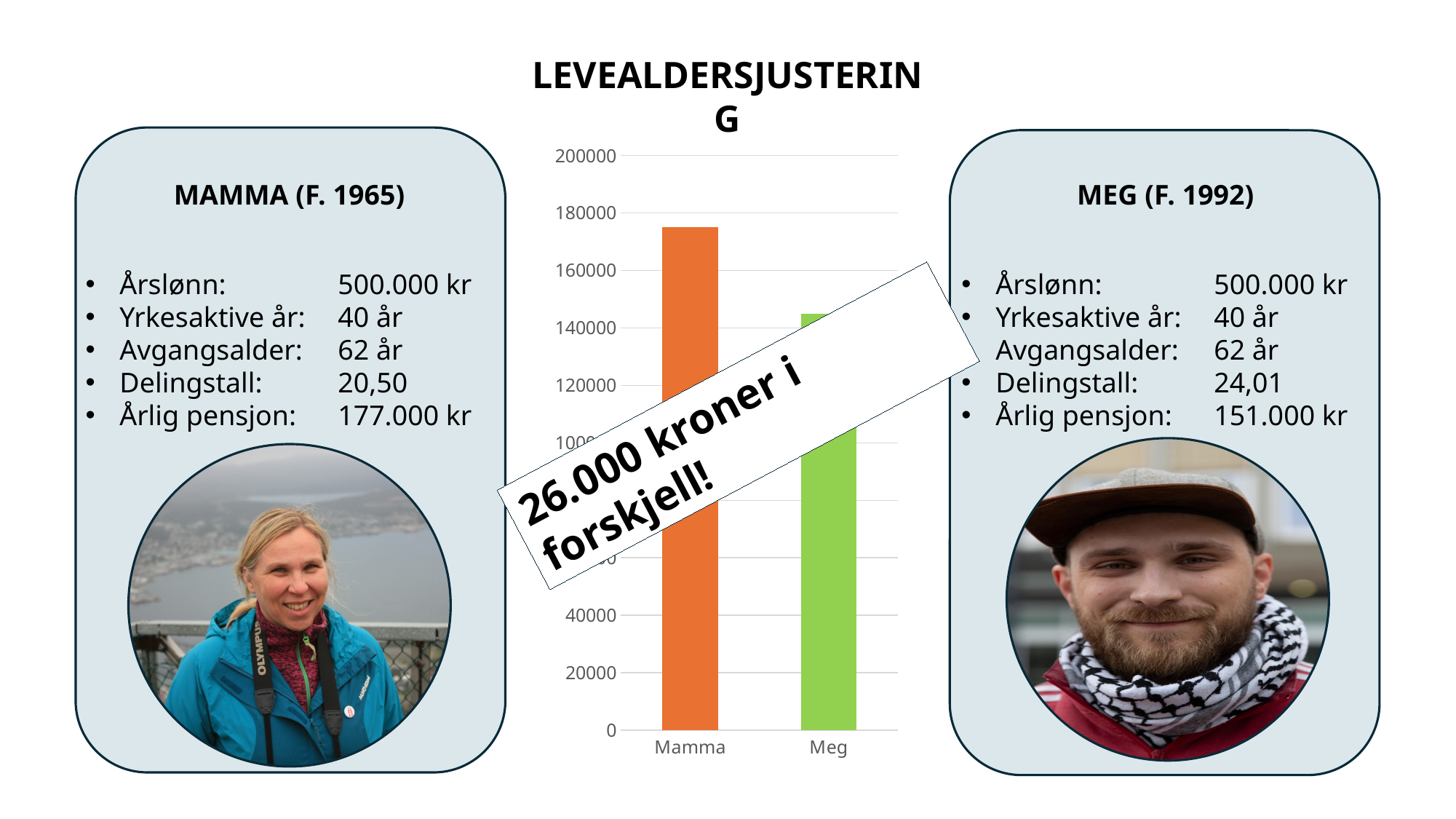
Which category has the lowest bar in the chart? Meg Is the value for Mamma greater or less than 160000? greater What is the title of the chart? LEVEALDERSJUSTERING What is the highest value shown on the vertical axis of the chart? 200000 What colour is the bar for Mamma? orange What kind of chart is shown on the slide? bar chart How many bars does the chart have? 2 Which category has the highest bar in the chart? Mamma Is the value for Meg greater or less than 160000? less Is the value for Meg greater or less than 120000? greater Which bar is taller, Mamma or Meg? Mamma